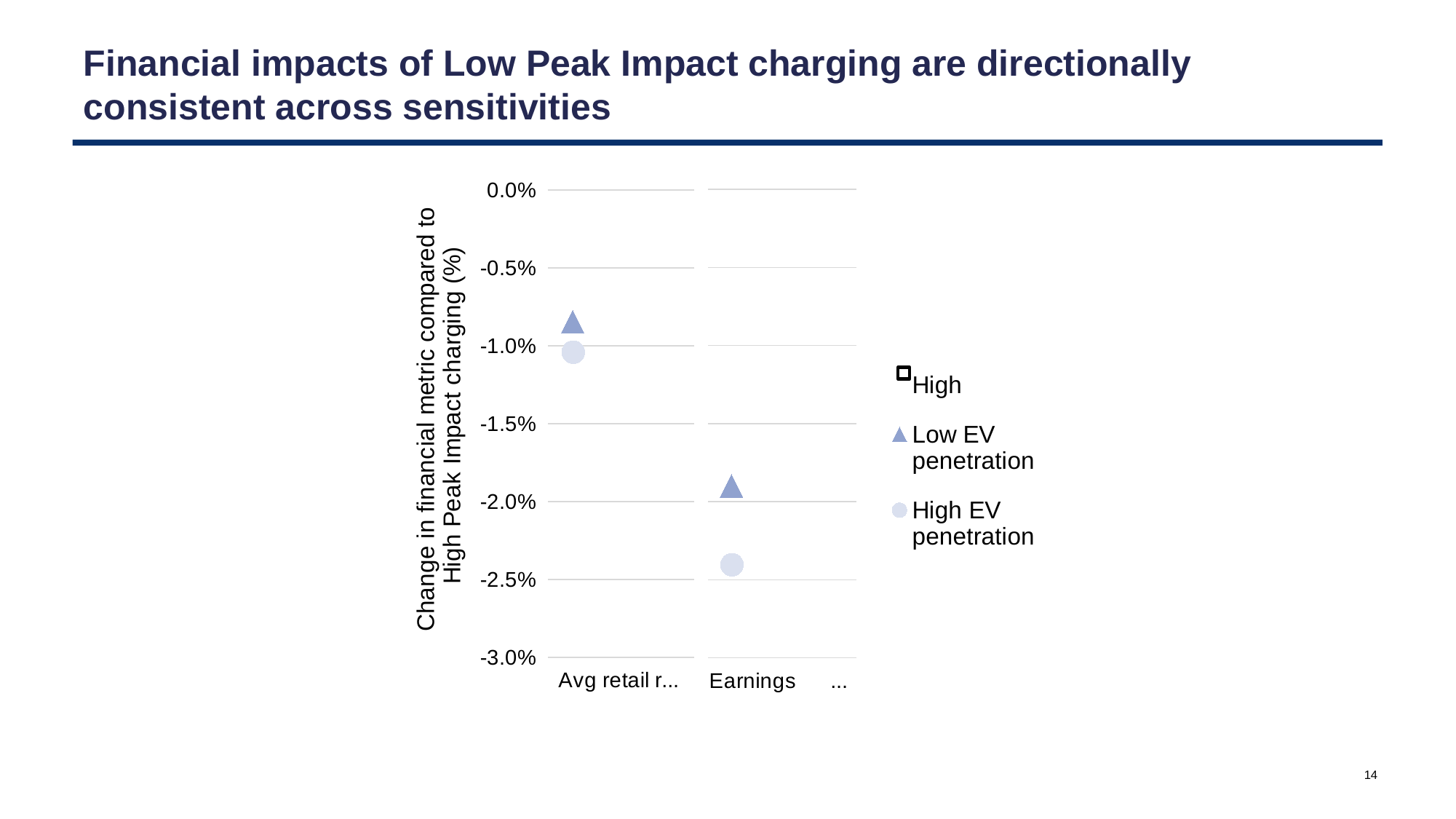
Is the High EV penetration value for Earnings greater or less than -2.0%? less For Earnings, which series has the higher (less negative) value: Low EV penetration or High EV penetration? Low EV penetration How many series does the legend list? 3 Is the Low EV penetration value for Earnings greater or less than -1.5%? less Do the values for the Low EV penetration series rise or fall from Avg retail r... to Earnings? fall What kind of chart is shown on the slide? scatter chart Is the High EV penetration value for Avg retail r... greater or less than -0.5%? less What are the three entries in the chart's legend? High, Low EV penetration, High EV penetration Which plotted point has the lowest value on the chart? High EV penetration for Earnings What is the title of the vertical axis? Change in financial metric compared to High Peak Impact charging (%) For the High EV penetration series, which category has the lower value: Avg retail r... or Earnings? Earnings